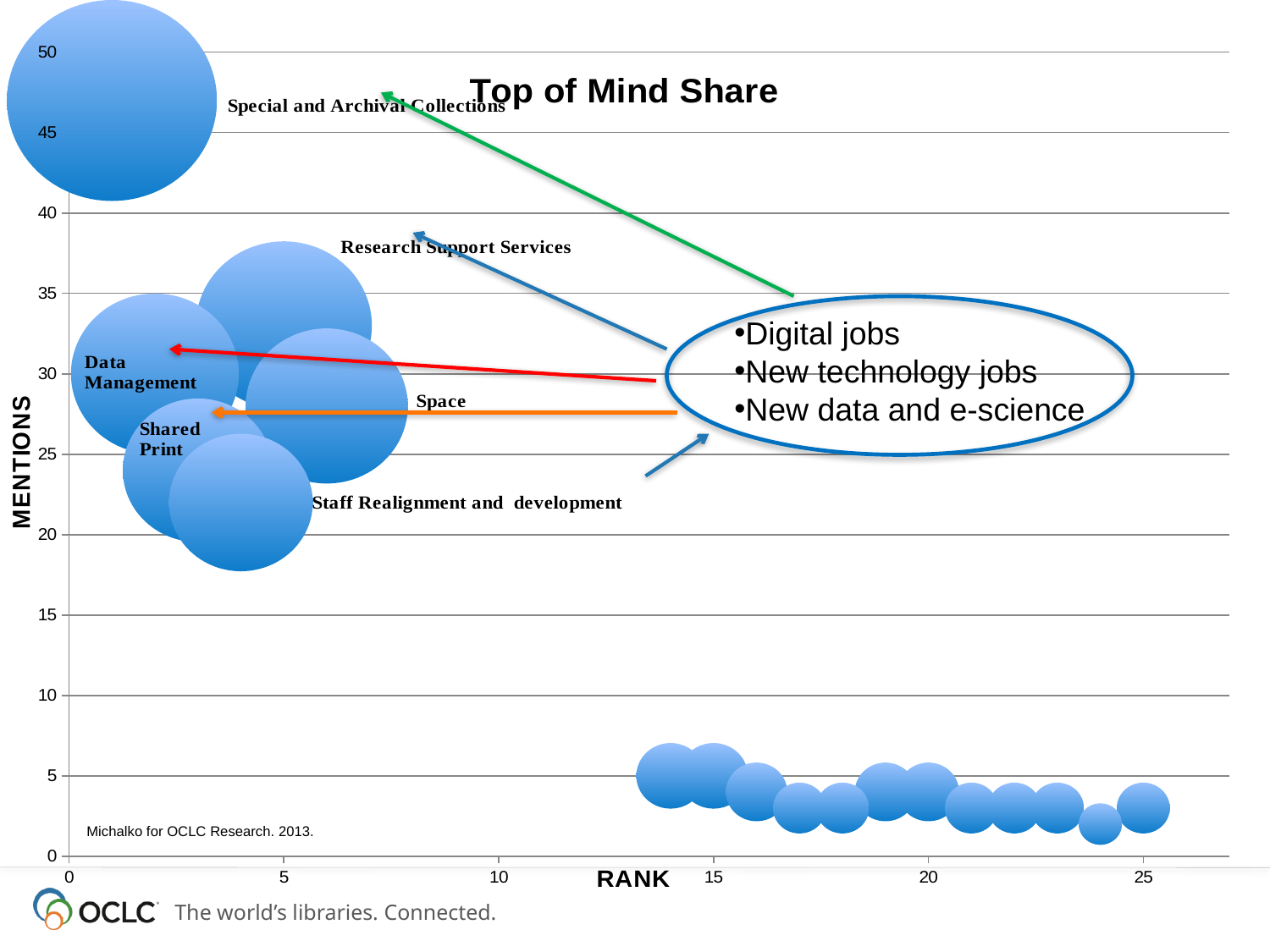
Is the number of mentions for Research Support Services greater or less than 30? greater Is the number of mentions for Special and Archival Collections greater or less than 40? greater Which has more mentions, Research Support Services or Staff Realignment and development? Research Support Services Which labeled topic has the highest number of mentions? Special and Archival Collections Is the number of mentions for Staff Realignment and development greater or less than 25? less What is the label of the vertical axis? MENTIONS Do the number of mentions rise or fall as rank increases along the x axis? fall What is the title of the chart? Top of Mind Share Which has more mentions, Special and Archival Collections or Research Support Services? Special and Archival Collections What kind of chart is shown on the slide? bubble chart